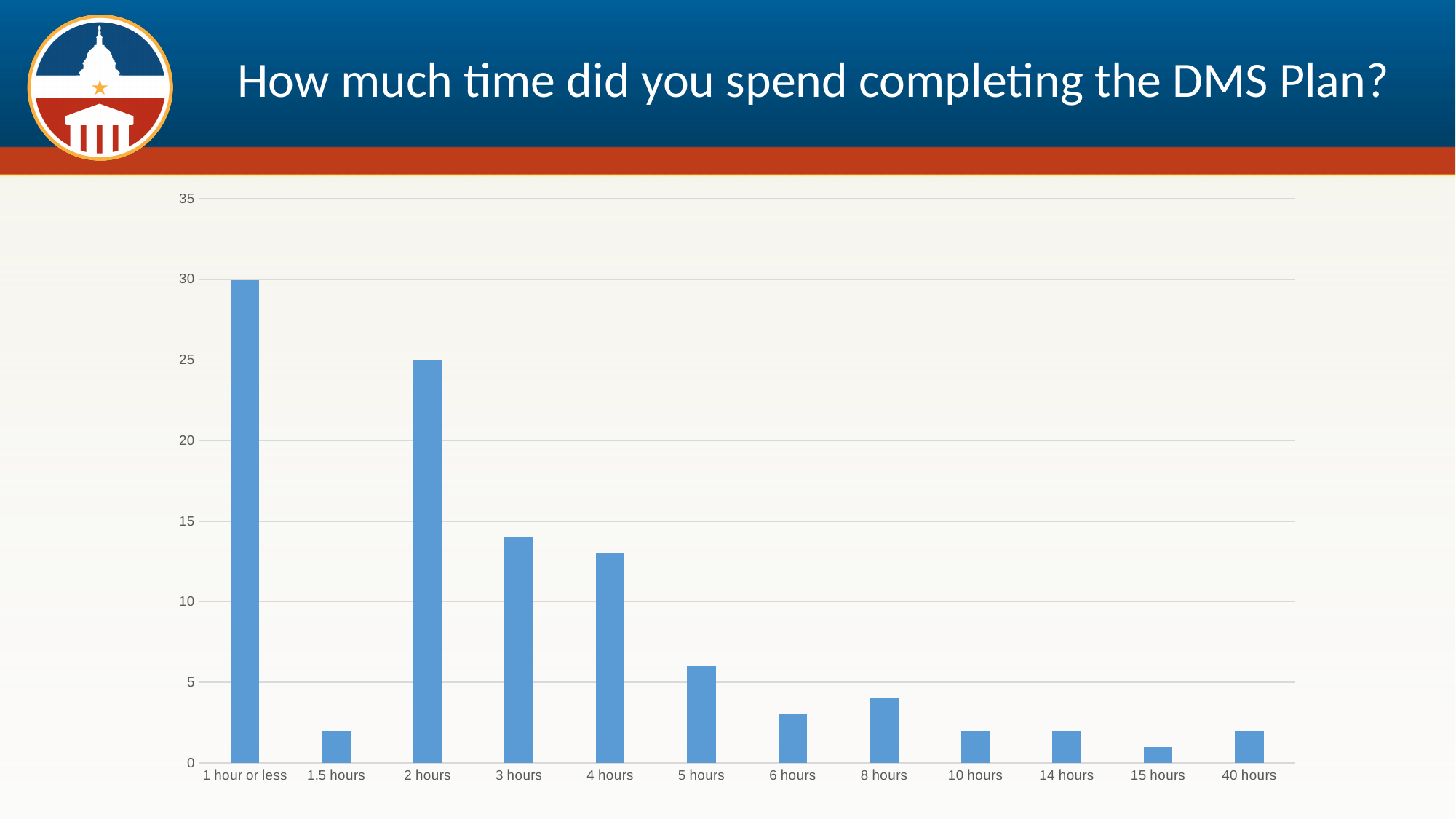
Which is larger, the value for "2 hours" or the value for "3 hours"? 2 hours What kind of chart is shown on the slide? bar chart What is the value for "1 hour or less"? 30 Which category has the highest value? 1 hour or less How many categories are shown on the x axis? 12 Is the value for "8 hours" greater or less than 5? less Is the value for "4 hours" greater or less than 15? less Which category has the lowest value? 15 hours Is the value for "3 hours" greater or less than 10? greater What is the title of the chart? How much time did you spend completing the DMS Plan? What is the difference between the values for "1 hour or less" and "2 hours"? 5 What is the value for "2 hours"? 25